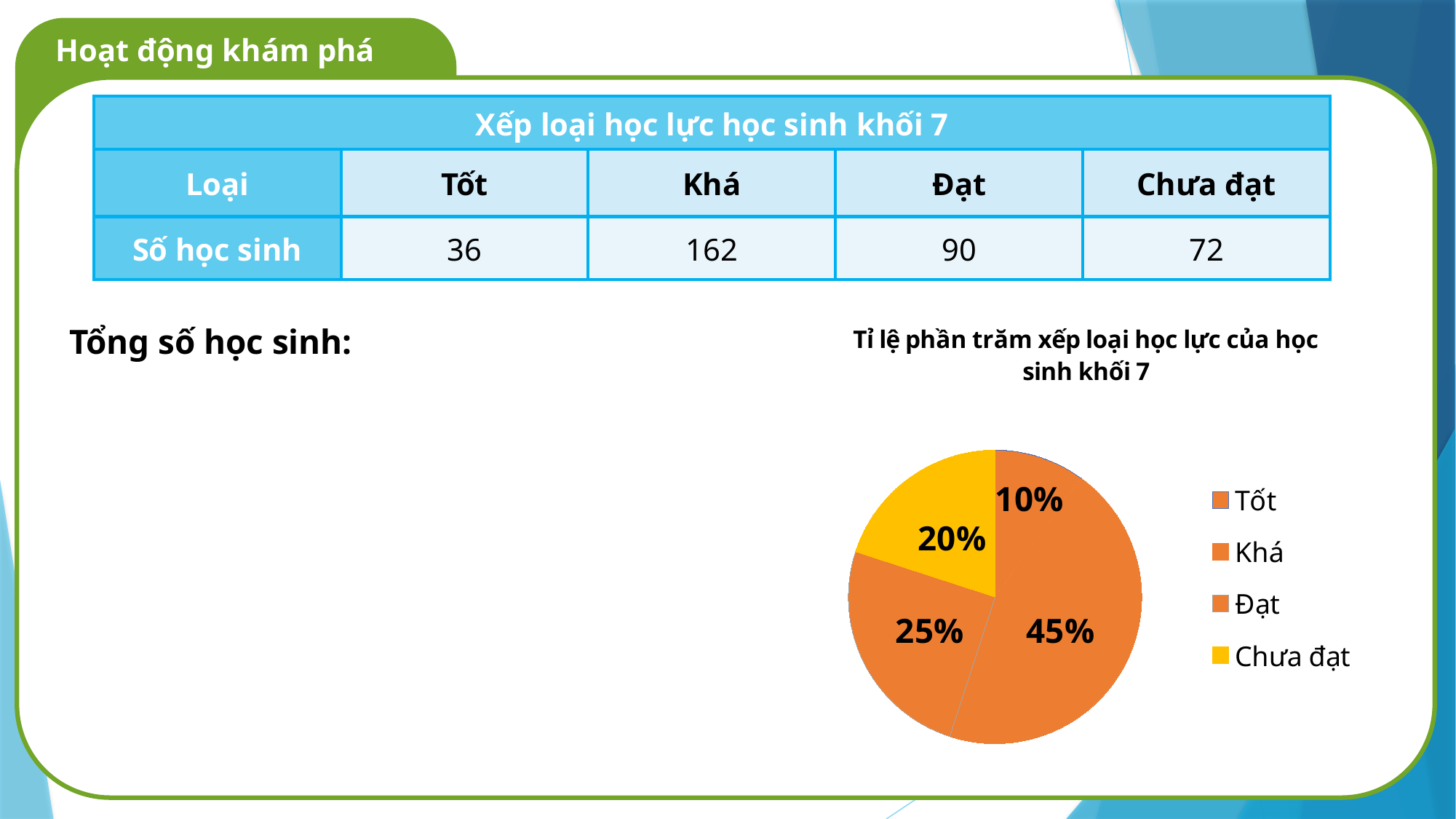
What percentage of the pie chart is the Đạt slice? 25% What percentage of the pie chart is the Chưa đạt slice? 20% What type of chart is shown on the slide? pie chart Which category has the smallest slice in the pie chart? Tốt Which category has the largest slice in the pie chart? Khá What is the difference in percentage points between the Khá slice and the Đạt slice in the pie chart? 20% In the pie chart, which slice is larger: Đạt or Chưa đạt? Đạt What percentage of the pie chart is the Tốt slice? 10% What percentage of the pie chart is the Khá slice? 45% How many categories does the legend of the pie chart list? 4 Which category is shown in yellow in the pie chart? Chưa đạt What is the title of the pie chart? Tỉ lệ phần trăm xếp loại học lực của học sinh khối 7